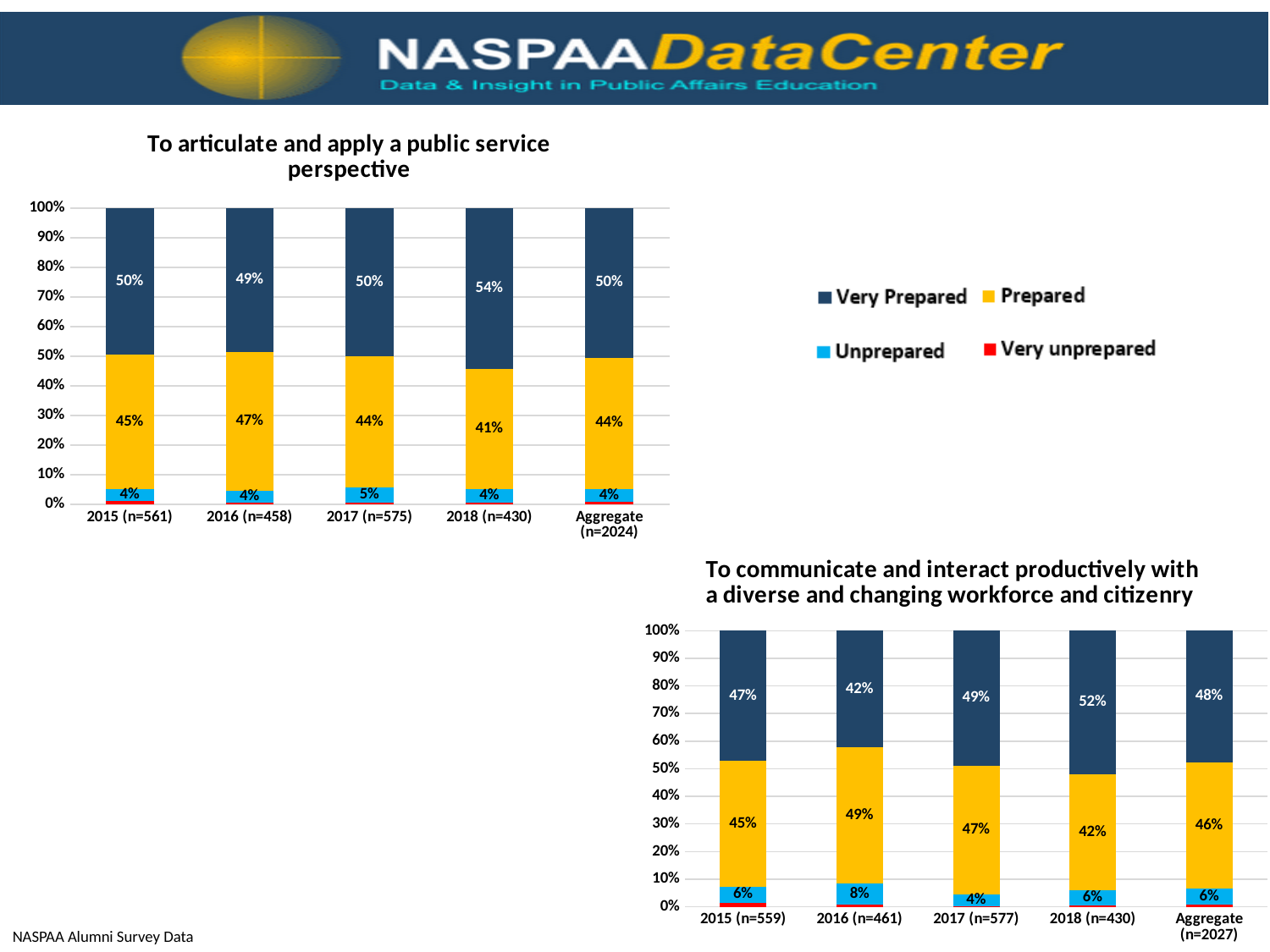
In the chart 'To articulate and apply a public service perspective', which category has the highest Very Prepared value? 2018 (n=430) In the chart 'To communicate and interact productively with a diverse and changing workforce and citizenry', what is the Unprepared value for 2016 (n=461)? 8% How many series does the legend on the slide list? 4 How many categories are shown on the x axis of the chart 'To communicate and interact productively with a diverse and changing workforce and citizenry'? 5 In the chart 'To articulate and apply a public service perspective', what is the difference between the Prepared values for 2016 (n=458) and 2018 (n=430)? 6% In the chart 'To articulate and apply a public service perspective', which category has the lowest Prepared value? 2018 (n=430) In the chart 'To communicate and interact productively with a diverse and changing workforce and citizenry', which is larger for 2017 (n=577): the Very Prepared value or the Prepared value? Very Prepared In the chart 'To communicate and interact productively with a diverse and changing workforce and citizenry', what is the Very Prepared value for the Aggregate (n=2027)? 48% In the chart 'To articulate and apply a public service perspective', what is the Prepared value for 2016 (n=458)? 47% What kind of chart is 'To articulate and apply a public service perspective'? Stacked bar chart In the chart 'To articulate and apply a public service perspective', what percentage of 2018 (n=430) respondents were Very Prepared? 54% In the chart 'To communicate and interact productively with a diverse and changing workforce and citizenry', which category has the lowest Very Prepared value? 2016 (n=461)